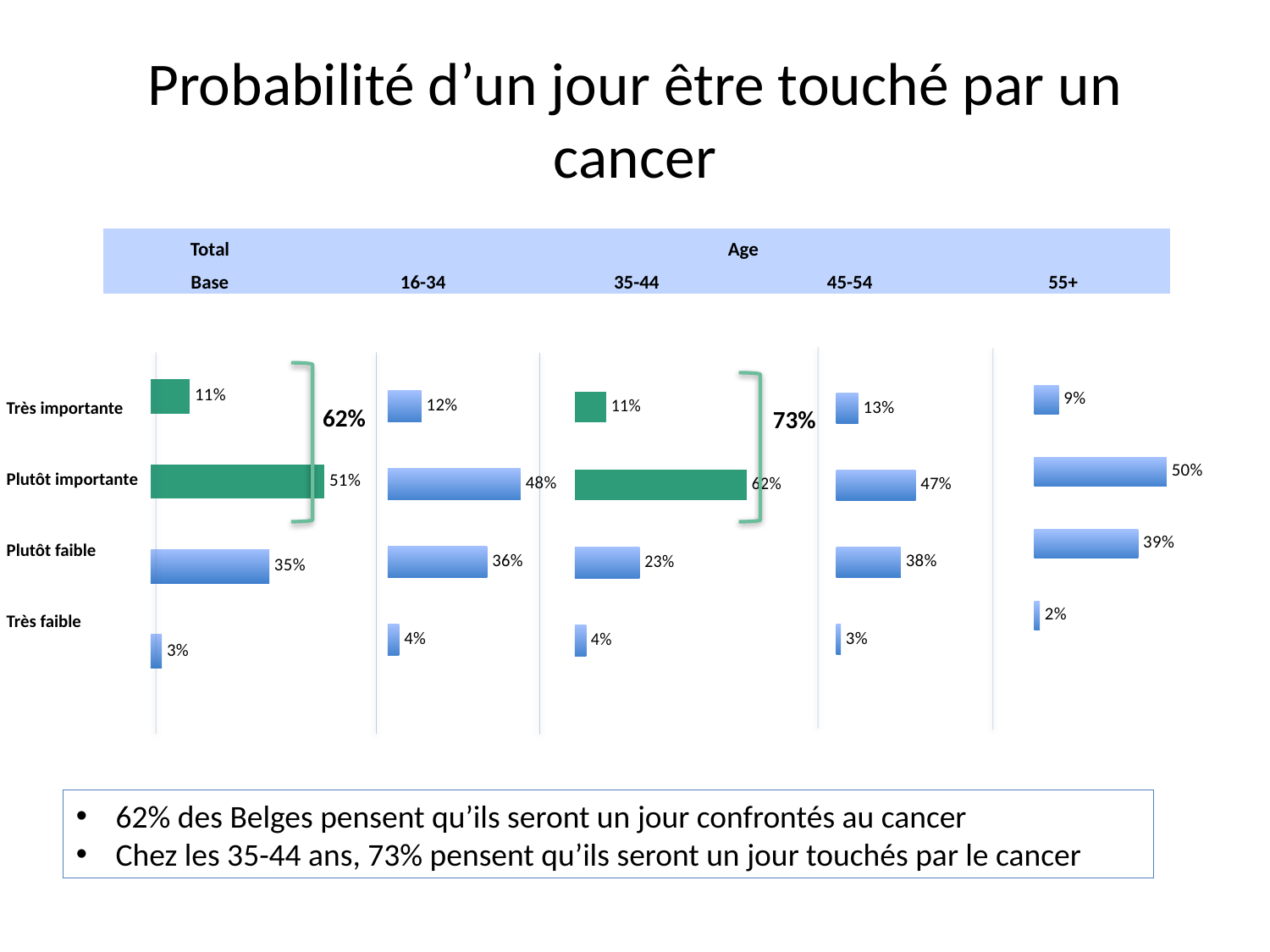
In the 45-54 chart, which category has the highest value? Plutôt importante What kind of chart is used for the Total Base data? Bar chart In the Total Base chart, what is the value for Plutôt importante? 51% In the 35-44 chart, what is the difference between Plutôt importante and Plutôt faible? 39% In the 35-44 chart, what is the value for Plutôt importante? 62% How many age groups are shown in the charts under the Age heading? 4 In the 16-34 chart, what is the value for Très importante? 12% Which is larger: Plutôt faible in the 55+ chart or Plutôt faible in the 45-54 chart? 55+ In the Total Base chart, what is the total of Très importante and Plutôt importante? 62% In the 16-34 chart, which category has the lowest value? Très faible In the 55+ chart, what is the value for Très faible? 2% How many categories are shown in the 16-34 chart? 4